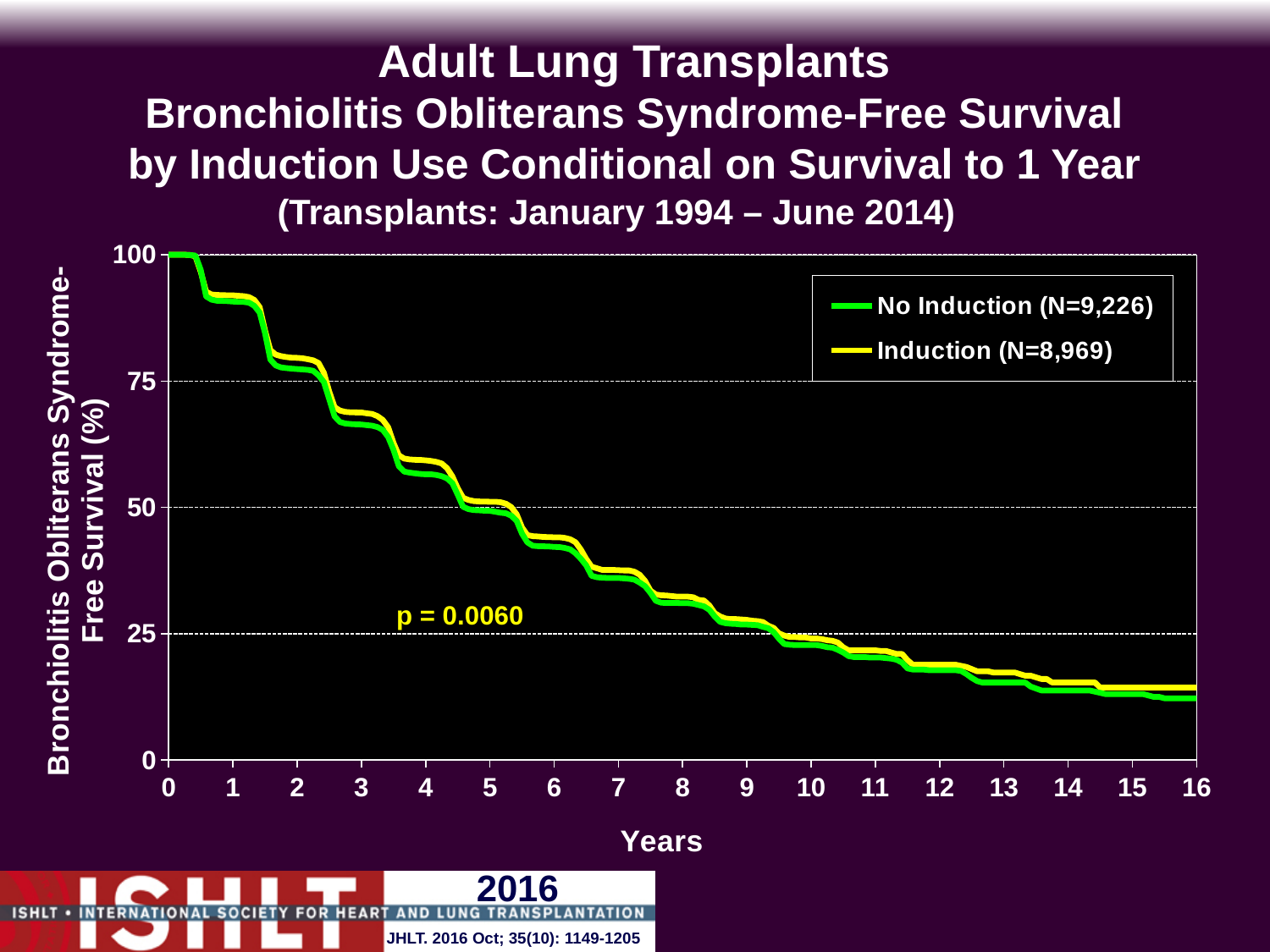
How many series does the legend list? 2 At year 15, which curve is higher, Induction or No Induction? Induction Is the value for the No Induction curve at year 1 greater or less than 75? greater Is the value for the Induction curve at year 4 greater or less than 50? greater Do the survival curves rise or fall as years increase along the x axis? fall What are the two series named in the legend? No Induction (N=9,226) and Induction (N=8,969) Is the value for the No Induction curve at year 8 greater or less than 25? greater What is the highest value shown on the x axis? 16 What kind of chart is shown on the slide? line chart What is the p-value printed on the chart? p = 0.0060